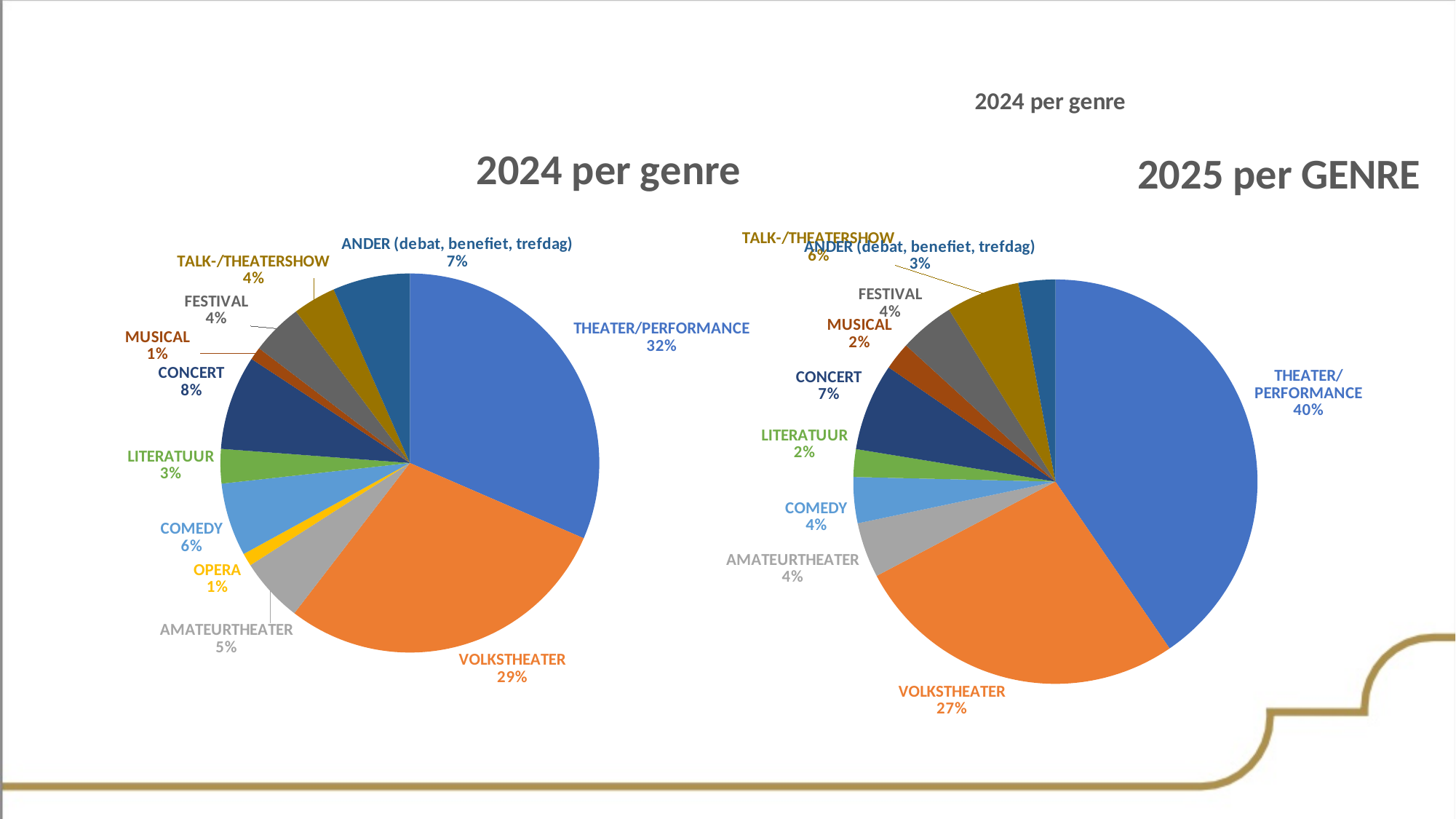
In the 2024 per genre chart, which is larger: the share for COMEDY or the share for AMATEURTHEATER? COMEDY In the 2024 per genre chart, what is the difference between the shares of THEATER/PERFORMANCE and VOLKSTHEATER? 3% What type of chart is used for the 2025 per GENRE data? Pie chart In the 2024 per genre chart, what share does THEATER/PERFORMANCE have? 32% In the 2025 per GENRE chart, which genre has the largest share? THEATER/PERFORMANCE In the 2025 per GENRE chart, what share does VOLKSTHEATER have? 27% In the 2024 per genre chart, what is the share for CONCERT? 8% In the 2025 per GENRE chart, what is the difference between the shares of THEATER/PERFORMANCE and VOLKSTHEATER? 13% How many genre slices are shown in the 2024 per genre chart? 11 In the 2024 per genre chart, which genre has the largest share? THEATER/PERFORMANCE In the 2025 per GENRE chart, what is the share for TALK-/THEATERSHOW? 6% How many genre slices are shown in the 2025 per GENRE chart? 10